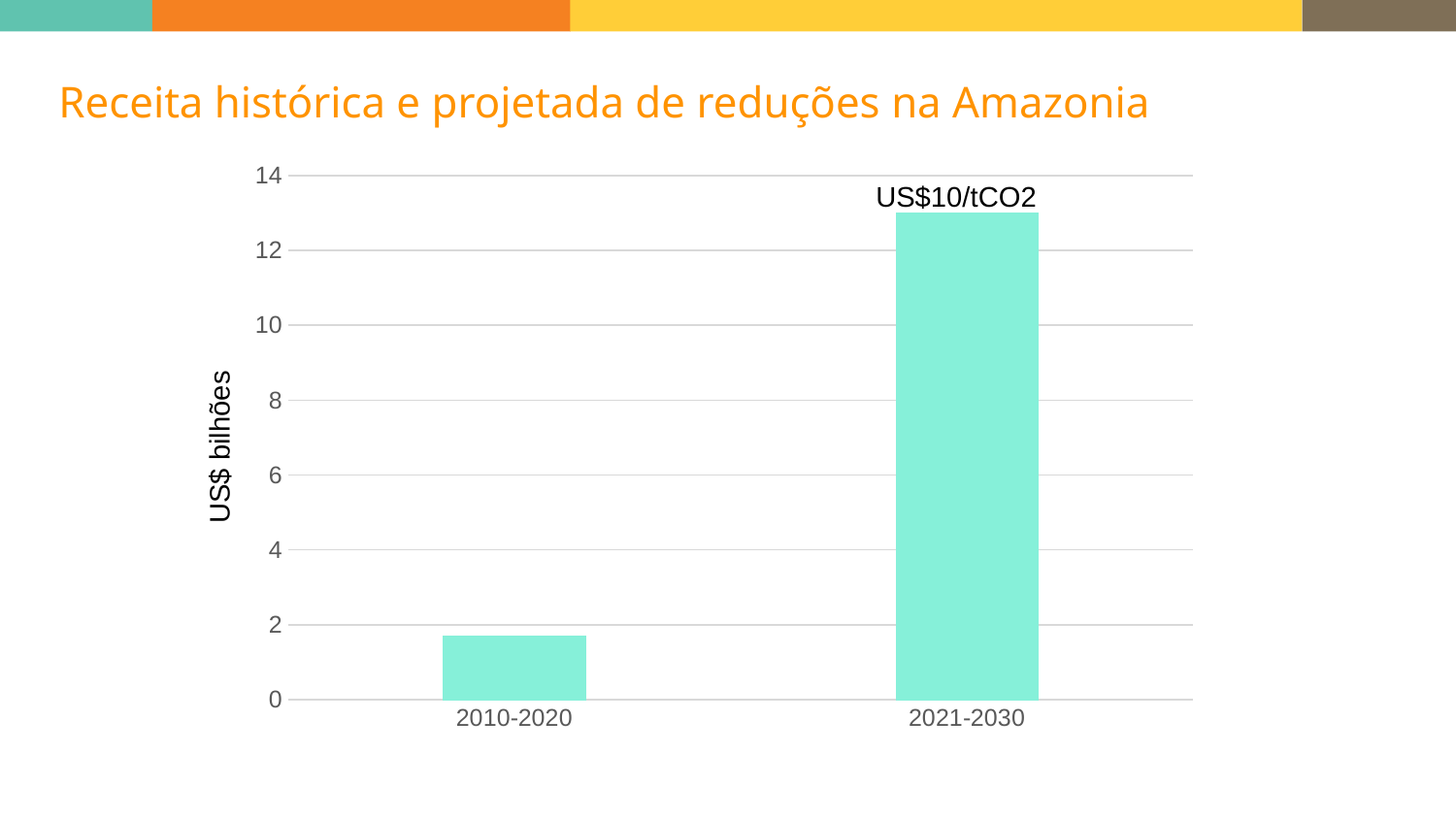
Is the value for 2021-2030 greater or less than 12? greater How many categories are shown on the x axis of the chart? 2 Which period has the highest value in the chart? 2021-2030 Which is larger, the value for 2010-2020 or the value for 2021-2030? 2021-2030 Is the value for 2021-2030 greater or less than 14? less What is the title of the chart on the slide? Receita histórica e projetada de reduções na Amazonia What kind of chart is shown on the slide? Bar chart What is the label on the y axis of the chart? US$ bilhões Do the values rise or fall from 2010-2020 to 2021-2030? rise Which period has the lowest value in the chart? 2010-2020 Is the value for 2010-2020 greater or less than 2? less